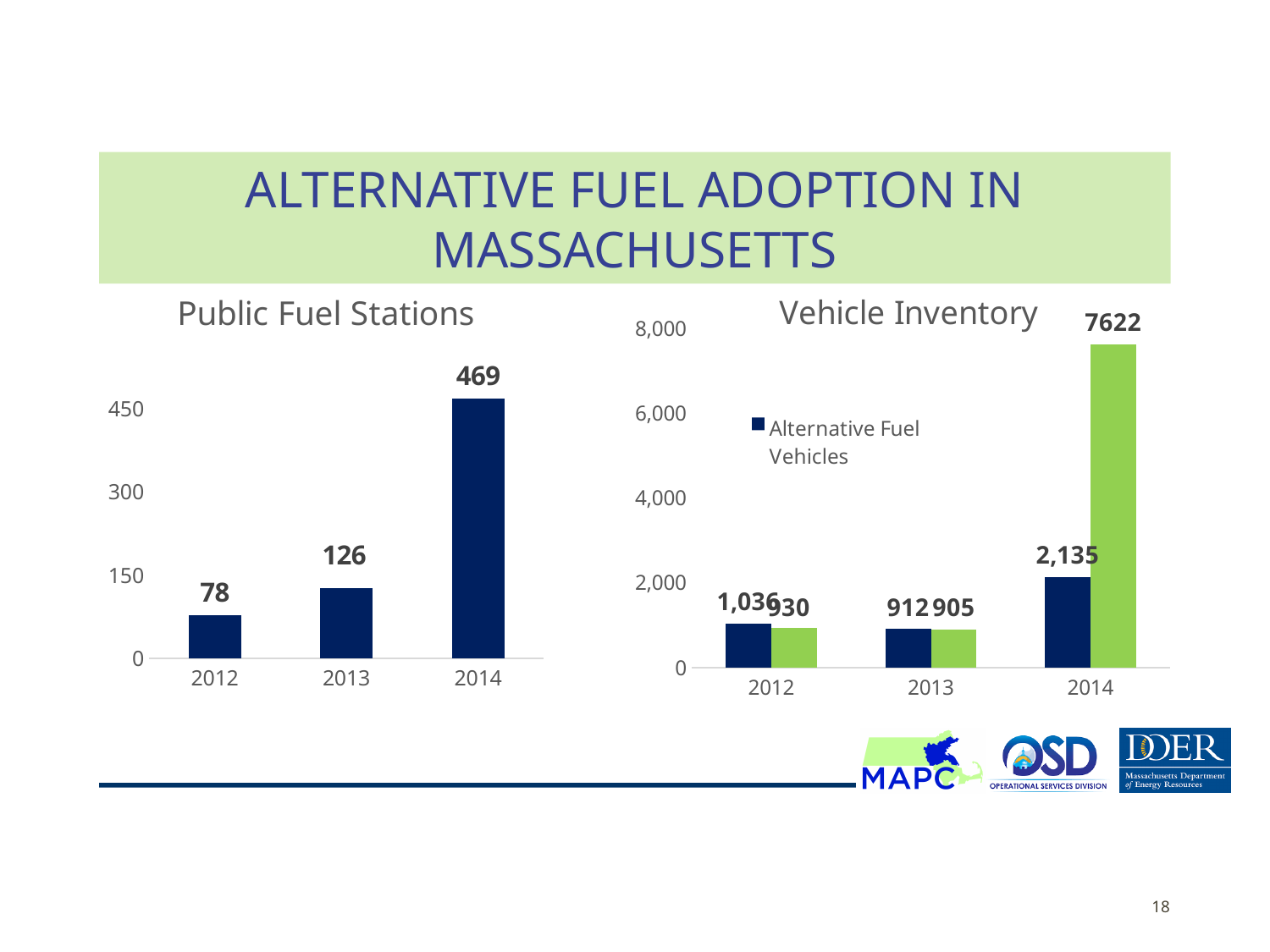
In the Vehicle Inventory chart, what is the value for Alternative Fuel Vehicles in 2012? 1,036 In the Public Fuel Stations chart, do the values rise or fall from 2012 to 2014? rise In the Vehicle Inventory chart, how many years are shown on the x axis? 3 What type of chart is the Public Fuel Stations chart? bar chart In the Vehicle Inventory chart, what is the value for Alternative Fuel Vehicles in 2014? 2,135 In the Public Fuel Stations chart, what is the value for 2014? 469 In the Public Fuel Stations chart, which year has the highest value? 2014 In the Public Fuel Stations chart, which year has the lowest value? 2012 In the Vehicle Inventory chart, is the Alternative Fuel Vehicles value for 2013 greater or less than 2,000? less In the Public Fuel Stations chart, what is the difference between the 2014 and 2013 values? 343 In the Vehicle Inventory chart, what is the largest value labelled on any bar? 7622 In the Public Fuel Stations chart, how many public fuel stations were there in 2012? 78